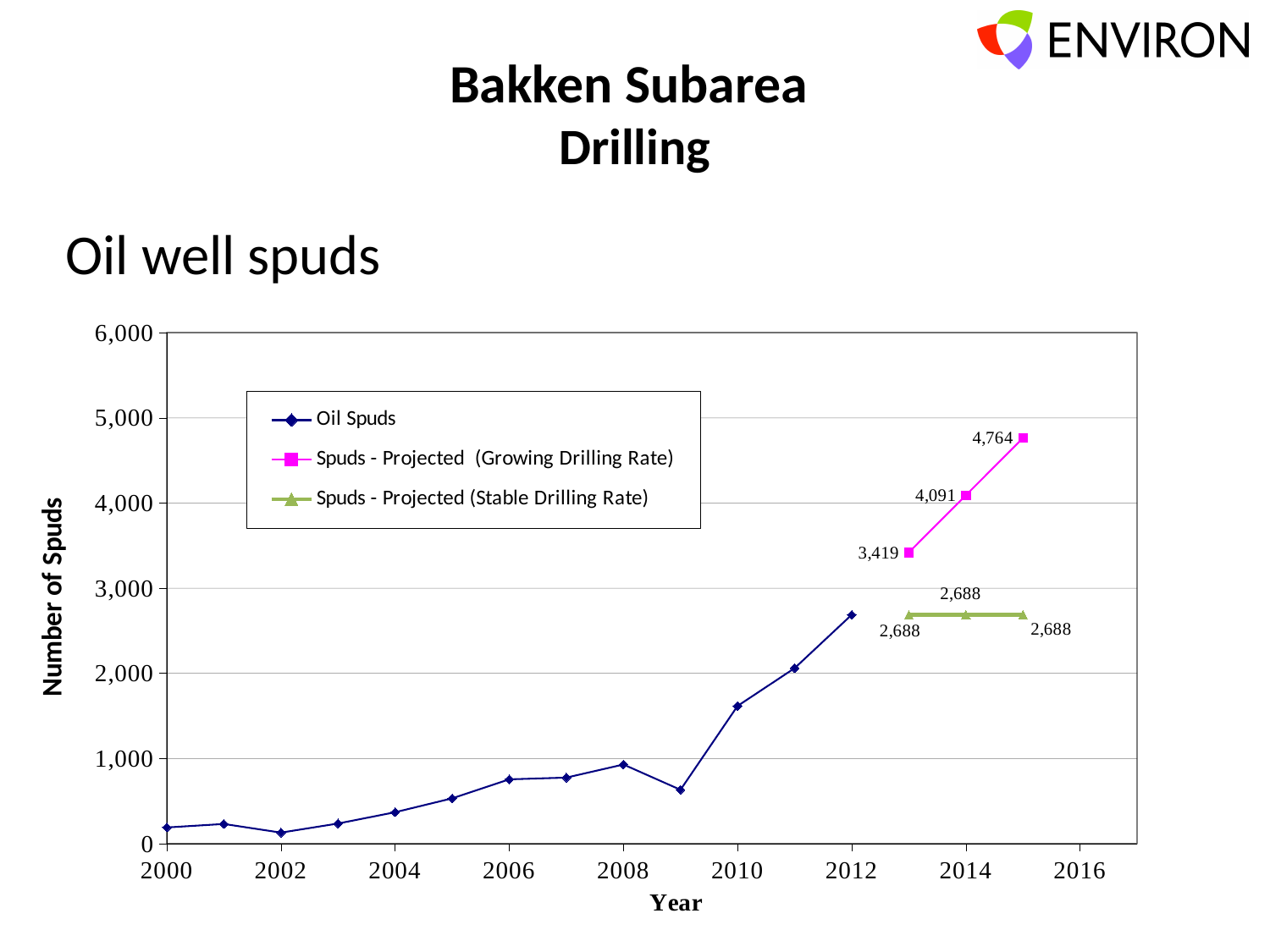
How many series does the legend list? 3 In 2015, how much higher is the growing drilling rate projection than the stable drilling rate projection? 2,076 What is the projected number of spuds in 2014 under the stable drilling rate? 2,688 Is the Oil Spuds value for 2009 greater or less than 1,000? less Do the values of the Spuds - Projected (Growing Drilling Rate) series rise or fall from 2013 to 2015? rise How many data points are plotted for the Spuds - Projected (Stable Drilling Rate) series? 3 What is the projected number of spuds in 2015 under the growing drilling rate? 4,764 What is the difference between the growing drilling rate projections for 2015 and 2013? 1,345 Which year has the highest value for the Spuds - Projected (Growing Drilling Rate) series? 2015 What type of chart is shown on the slide? line chart What is the projected number of spuds in 2013 under the growing drilling rate? 3,419 Is the Oil Spuds value for 2010 greater or less than 1,500? greater